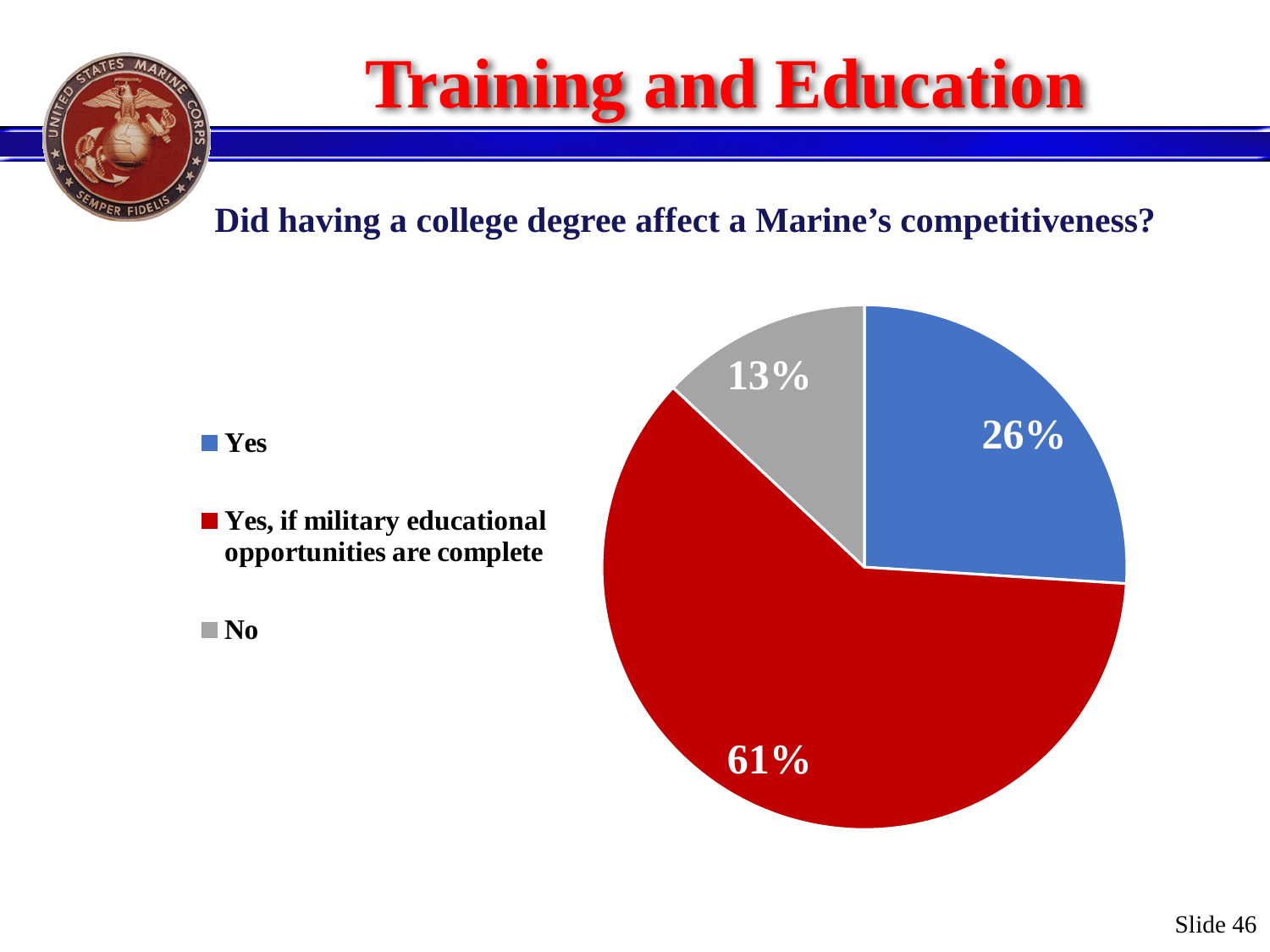
What percentage of respondents answered "Yes"? 26% Which response has the largest share of the pie? Yes, if military educational opportunities are complete What is the difference in percentage points between the "Yes, if military educational opportunities are complete" slice and the "Yes" slice? 35 What percentage of respondents answered "Yes, if military educational opportunities are complete"? 61% What colour is the slice for "No"? grey How many slices does the pie chart have? 3 What is the difference in percentage points between the "Yes" slice and the "No" slice? 13 What question does the pie chart answer, according to the text above it? Did having a college degree affect a Marine's competitiveness? Which response has the smallest share of the pie? No Which is larger, the "Yes" slice or the "No" slice? Yes What kind of chart is shown on the slide? pie chart What percentage of respondents answered "No"? 13%